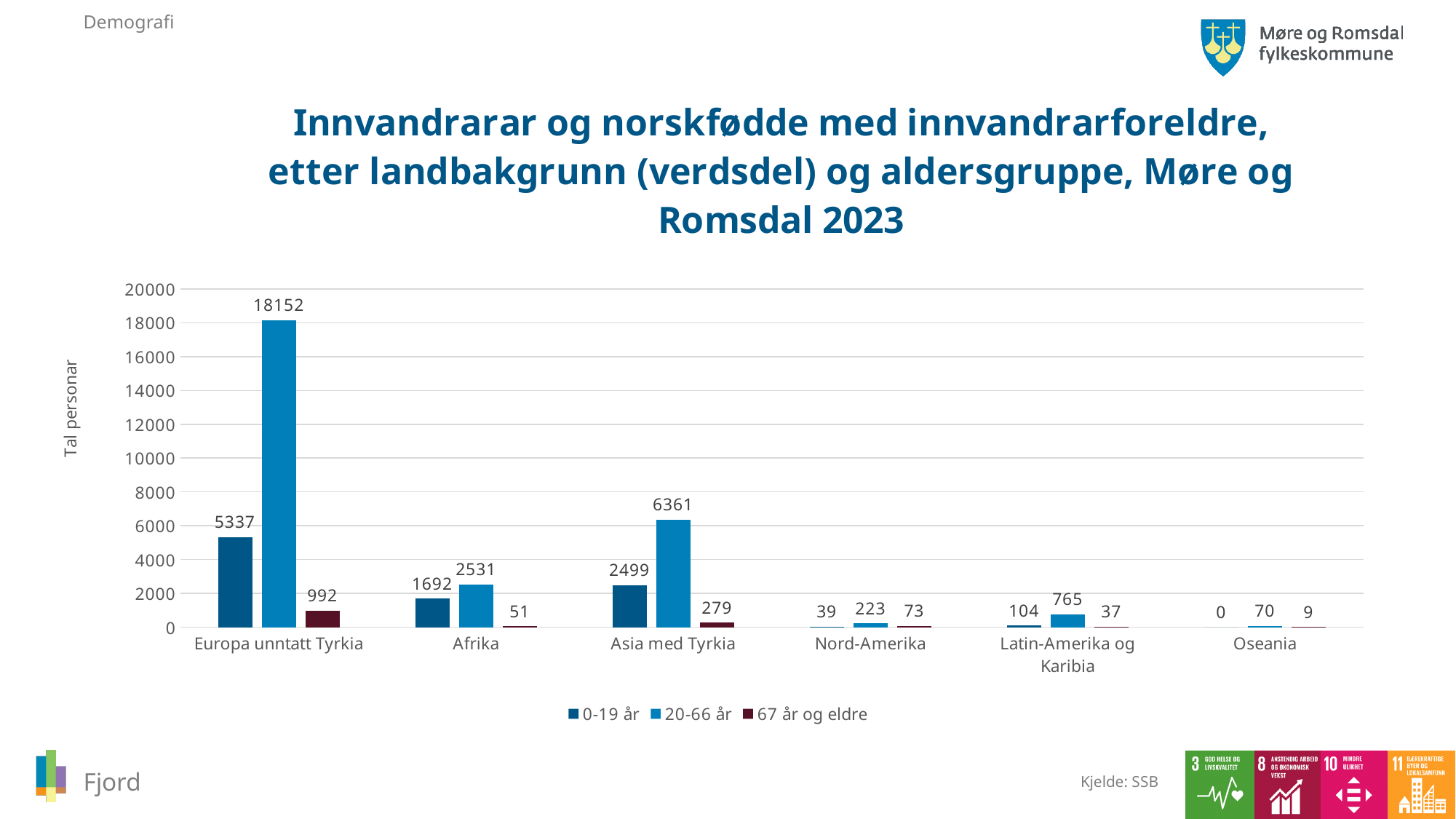
What is the value for the 20-66 år series for Europa unntatt Tyrkia? 18152 What is the difference between the 20-66 år and 0-19 år values for Afrika? 839 What is the value for the 20-66 år series for Latin-Amerika og Karibia? 765 What is the value for the 0-19 år series for Asia med Tyrkia? 2499 What is the difference between the 20-66 år values for Europa unntatt Tyrkia and Asia med Tyrkia? 11791 What is the value for the 67 år og eldre series for Afrika? 51 Which category has the highest value in the 20-66 år series? Europa unntatt Tyrkia What kind of chart is shown on the slide? Bar chart Which is larger: the 67 år og eldre value for Nord-Amerika or for Latin-Amerika og Karibia? Nord-Amerika How many categories are shown on the x axis? 6 How many series does the legend list? 3 Which category has the lowest value in the 0-19 år series? Oseania